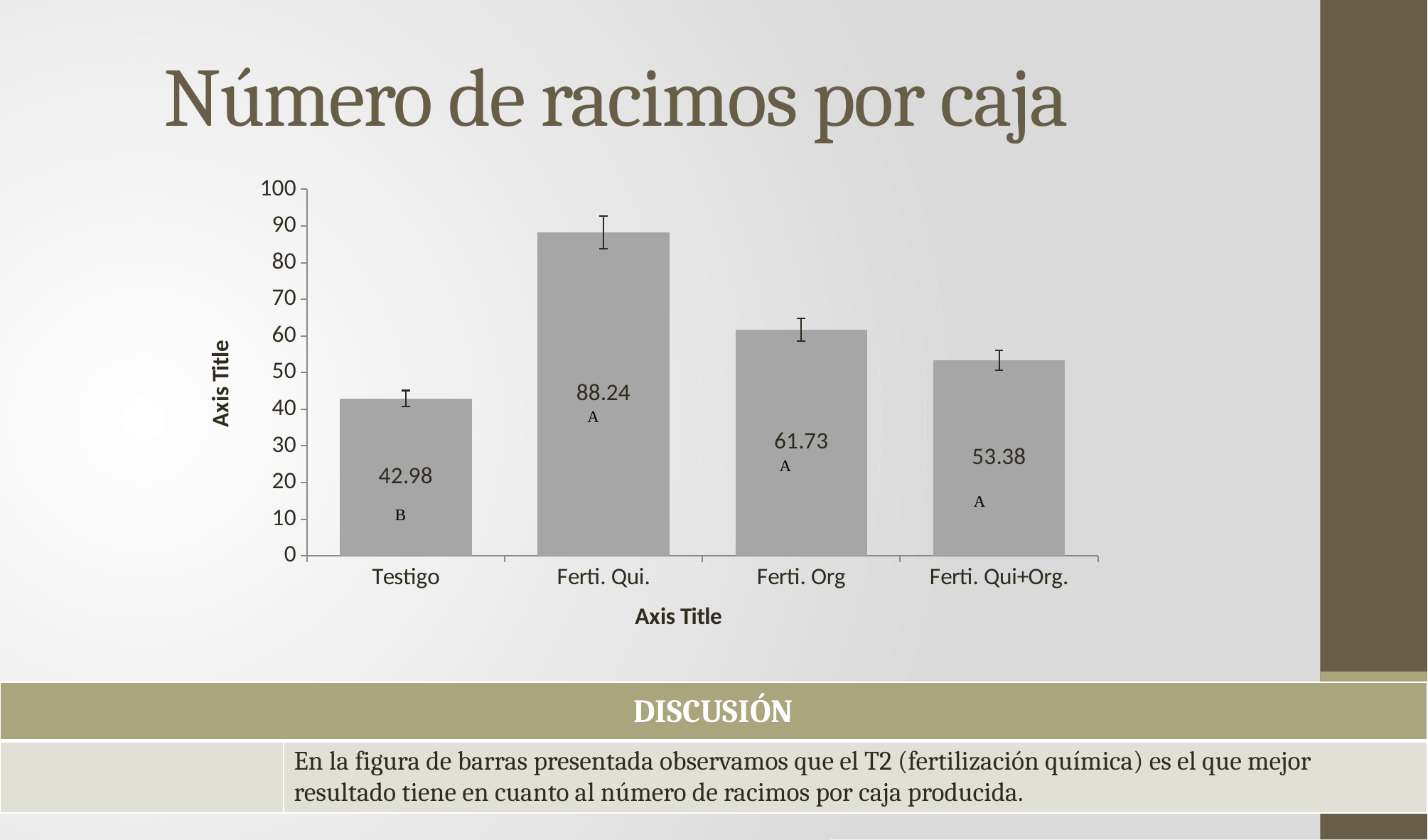
Which category has the highest value? Ferti. Qui. Is the value for Ferti. Qui+Org. greater or less than 50? greater What is the difference between the values for Ferti. Qui. and Testigo? 45.26 What kind of chart is shown on the slide? bar chart Which category has the lowest value? Testigo What is the difference between the values for Ferti. Org and Ferti. Qui+Org.? 8.35 What is the value for Ferti. Qui+Org.? 53.38 How many categories are shown on the x axis? 4 What is the value for Ferti. Qui.? 88.24 What is the value for Ferti. Org? 61.73 What is the value for Testigo? 42.98 Which is larger, the value for Ferti. Org or the value for Ferti. Qui+Org.? Ferti. Org